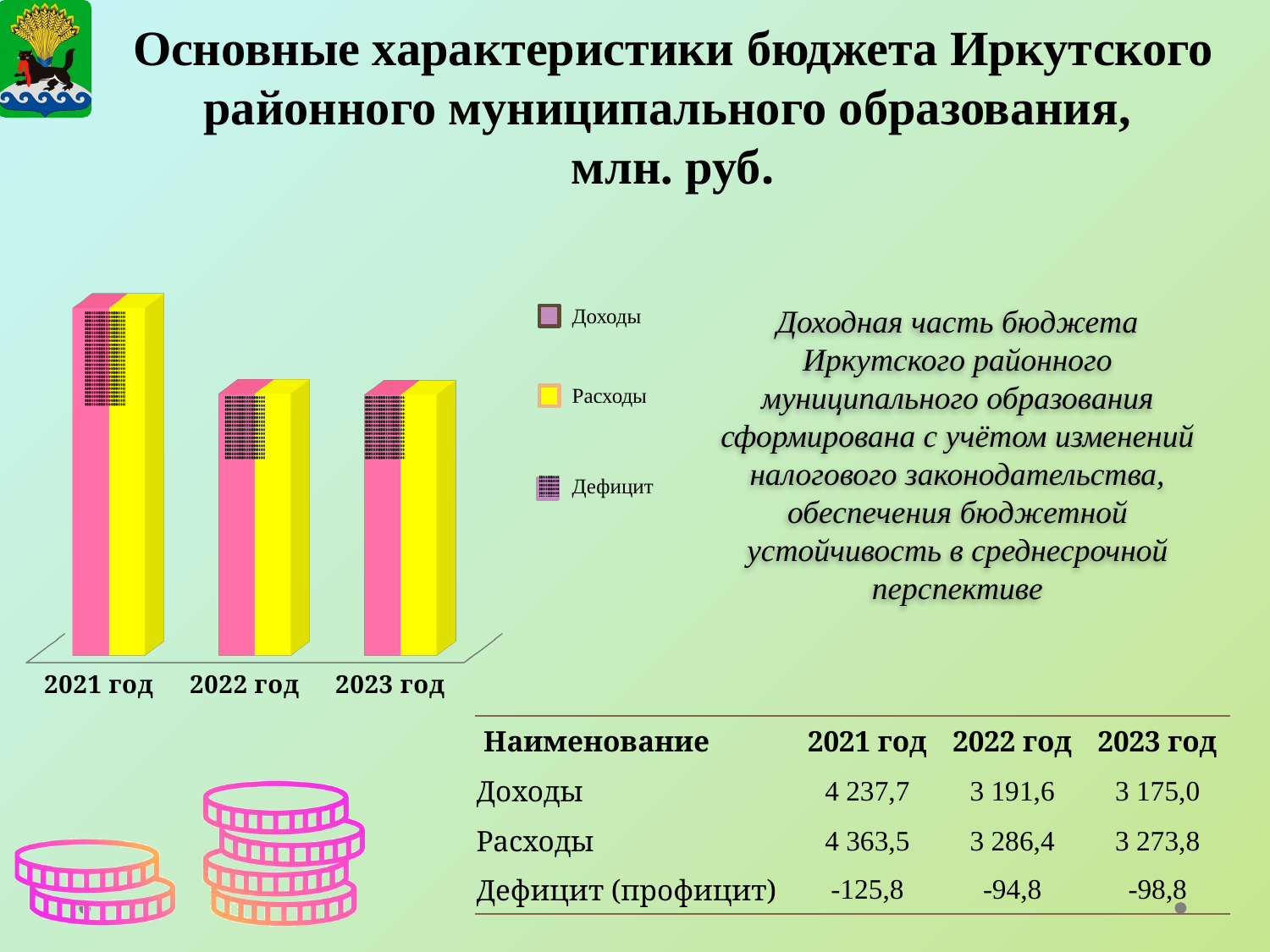
Do the bar heights rise or fall from 2021 год to 2022 год? fall Which legend entry is shown in yellow? Расходы According to the table on the slide, what is the value of Доходы for 2021 год? 4 237,7 How many series does the chart legend list? 3 Which year has the tallest bars in the chart? 2021 год Which legend entry is shown with a dotted pattern? Дефицит Which is larger in 2021 год, Доходы or Расходы? Расходы How many years (categories) are shown on the x axis of the chart? 3 According to the table on the slide, what is the value of Расходы for 2023 год? 3 273,8 What kind of chart is shown on the slide? bar chart What is the difference between Расходы and Доходы for 2021 год, using the table values? 125,8 According to the table on the slide, what is the value of Дефицит (профицит) for 2022 год? -94,8